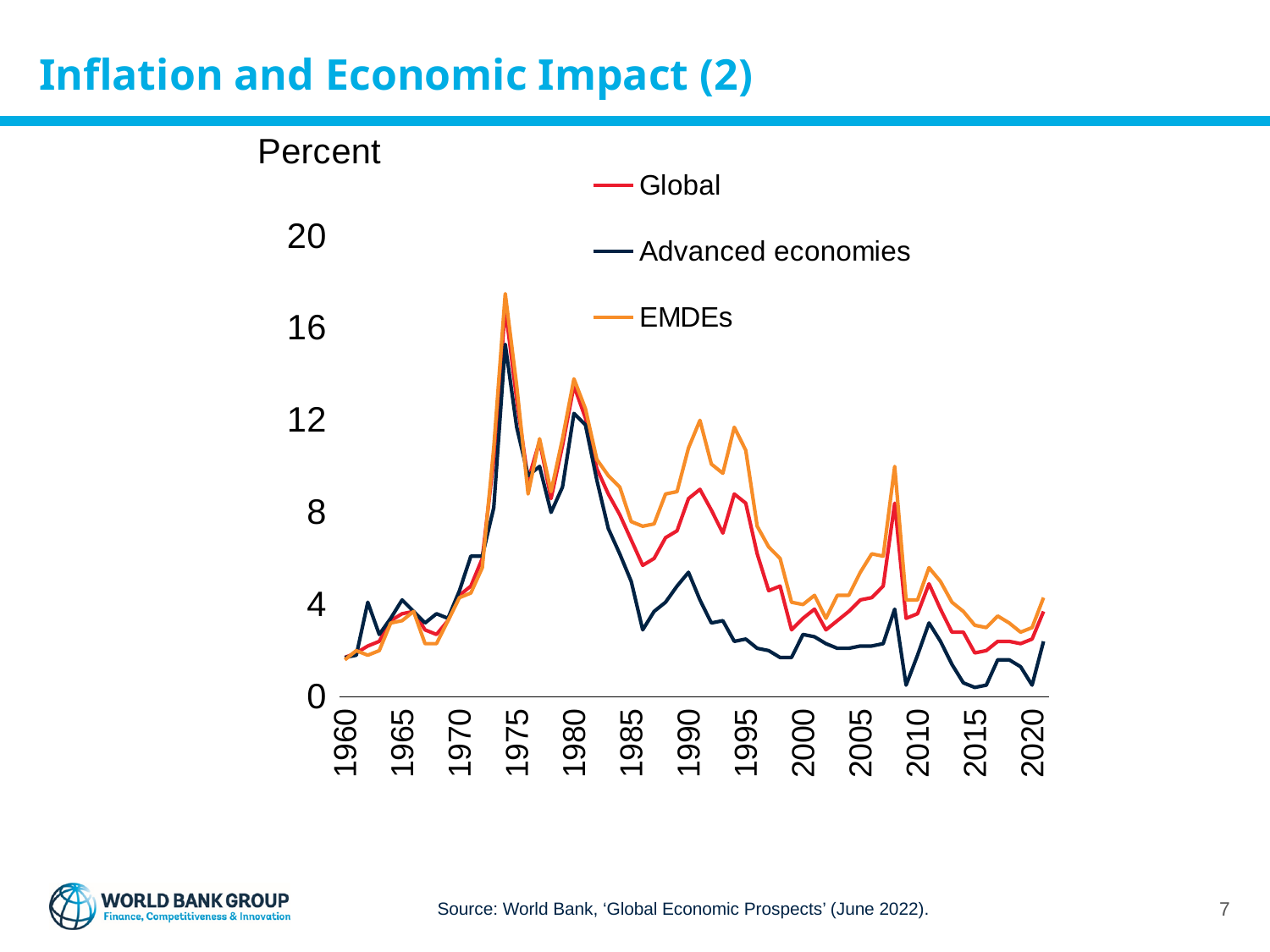
Is the peak value of the EMDEs series around 1974 greater or less than 16? greater How many series does the legend list? 3 Is the value for Advanced economies in 2015 greater or less than 4? less What kind of chart is shown on the slide? Line chart What are the three series named in the legend? Global, Advanced economies, EMDEs Is the value for EMDEs in 2008 greater or less than 8? greater Does the Advanced economies series rise or fall between 1980 and 1985? Fall Which series reaches the highest peak on the chart? EMDEs In 1990, which is higher: EMDEs or Advanced economies? EMDEs What unit label is shown above the vertical axis? Percent How many year labels are shown on the horizontal axis? 13